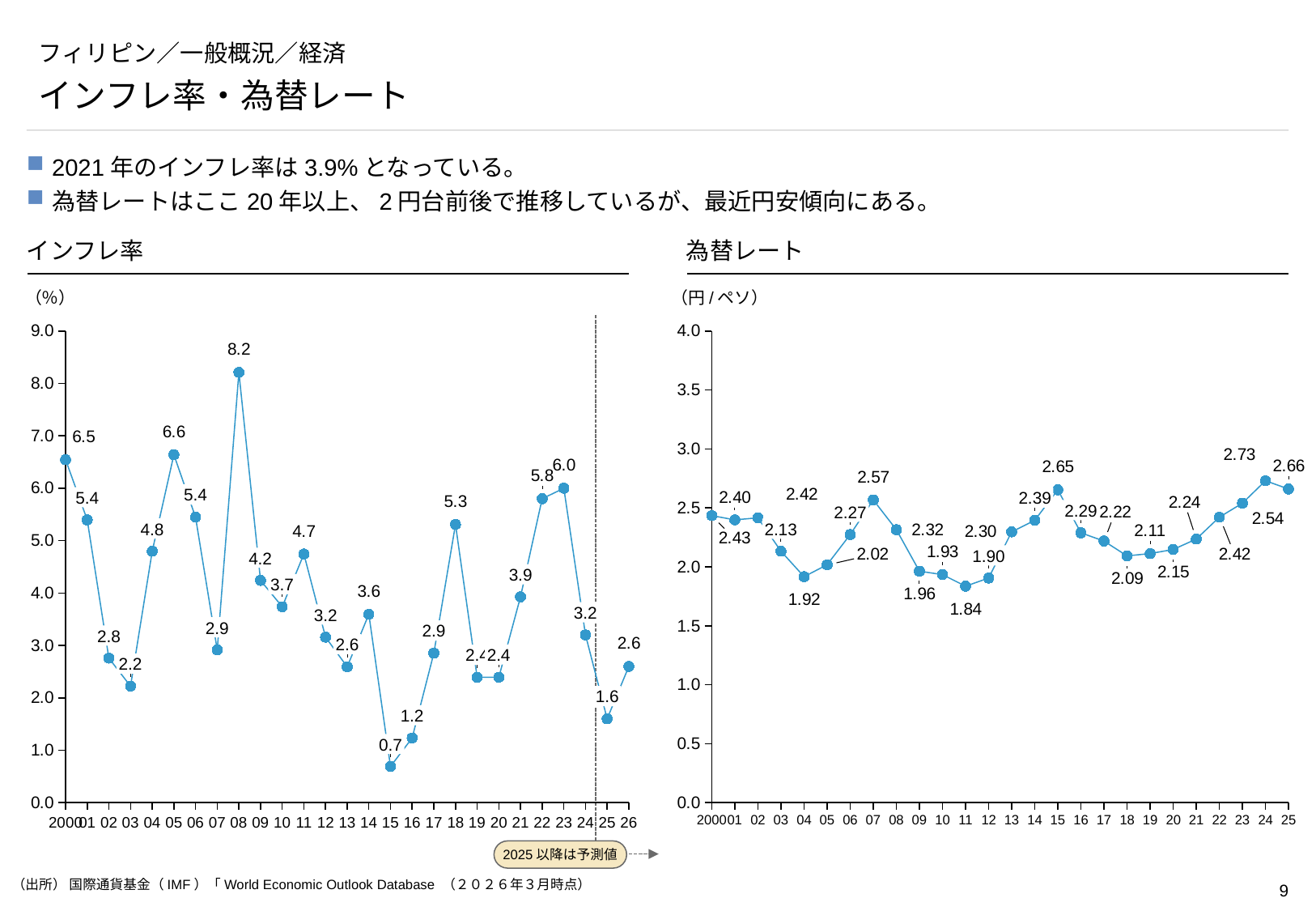
On the インフレ率 chart, what is the inflation rate for 2021? 3.9 On the 為替レート chart, what is the value for 2024? 2.73 On the インフレ率 chart, what is the inflation rate for 2008? 8.2 What unit is shown on the y axis of the 為替レート chart? 円/ペソ On the インフレ率 chart, which year has the highest inflation rate? 2008 On the インフレ率 chart, what is the difference between the 2008 value and the 2015 value? 7.5 On the 為替レート chart, do the values rise or fall from 2018 to 2024? rise On the インフレ率 chart, which year has the lowest inflation rate? 2015 What kind of chart is the 為替レート chart? line chart On the インフレ率 chart, which is larger, the value for 2022 or the value for 2024? 2022 On the 為替レート chart, which year has the highest value? 2024 On the 為替レート chart, which year has the lowest value? 2011